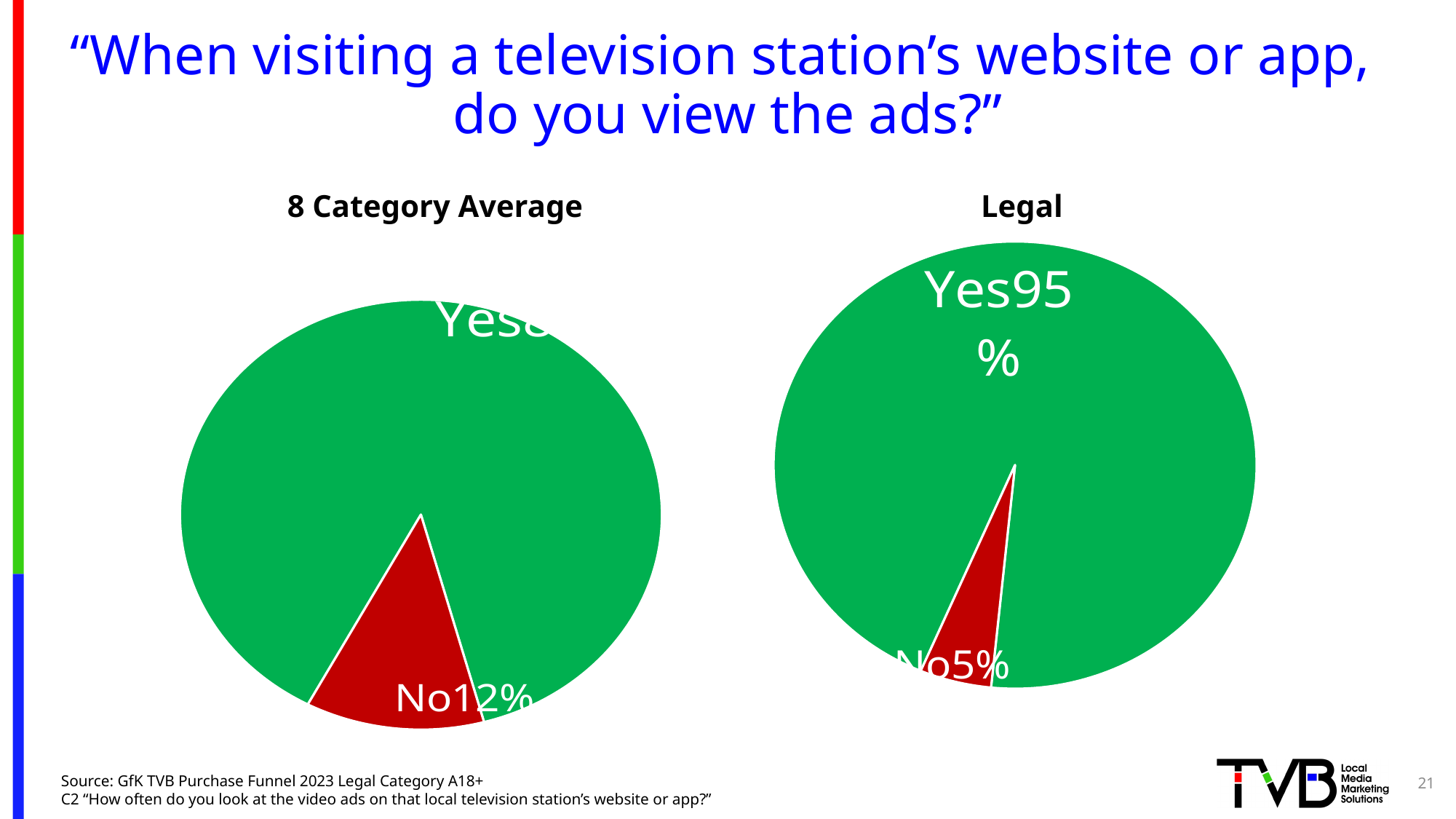
How many pie charts are shown on the slide? 2 What type of chart is used for the Legal data? Pie chart In the Legal pie chart, what is the difference between the Yes and No percentages? 90% In the 8 Category Average pie chart, which slice is the smallest? No In the Legal pie chart, which slice is the largest? Yes In the Legal pie chart, what percentage answered Yes? 95% In the 8 Category Average pie chart, what percentage answered No? 12% What colour is the No slice in the 8 Category Average pie chart? Red In the Legal pie chart, what percentage answered No? 5% How many slices does the Legal pie chart have? 2 Which chart has the larger No share, 8 Category Average or Legal? 8 Category Average What is the difference between the No percentage in the 8 Category Average chart and the No percentage in the Legal chart? 7%